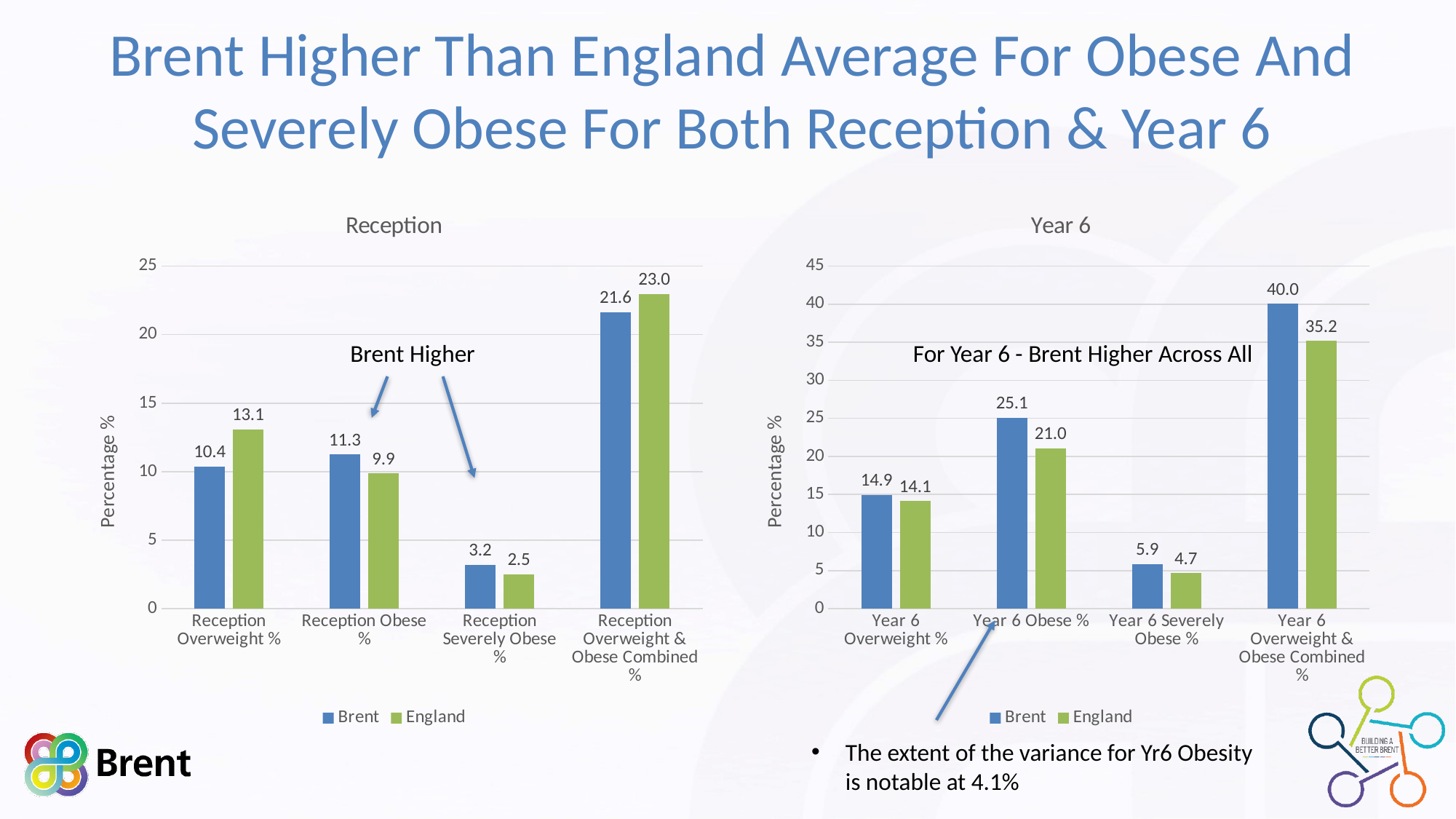
In the Reception chart, which category has the lowest England value? Reception Severely Obese % In the Reception chart, what is the England value for Reception Severely Obese %? 2.5 In the Reception chart, what is the difference between the England and Brent values for Reception Overweight %? 2.7 In the Reception chart, what is the Brent value for Reception Obese %? 11.3 In the Year 6 chart, which category has the highest Brent value? Year 6 Overweight & Obese Combined % In the Year 6 chart, is the Brent value for Year 6 Obese % greater or less than 20? greater In the Year 6 chart, what is the England value for Year 6 Overweight & Obese Combined %? 35.2 In the Year 6 chart, what is the difference between the Brent and England values for Year 6 Obese %? 4.1 What type of chart is the Year 6 chart? Bar chart In the Reception chart, which is larger for Reception Overweight %: Brent or England? England How many categories are shown on the x axis of the Year 6 chart? 4 How many series does the legend of the Reception chart list? 2